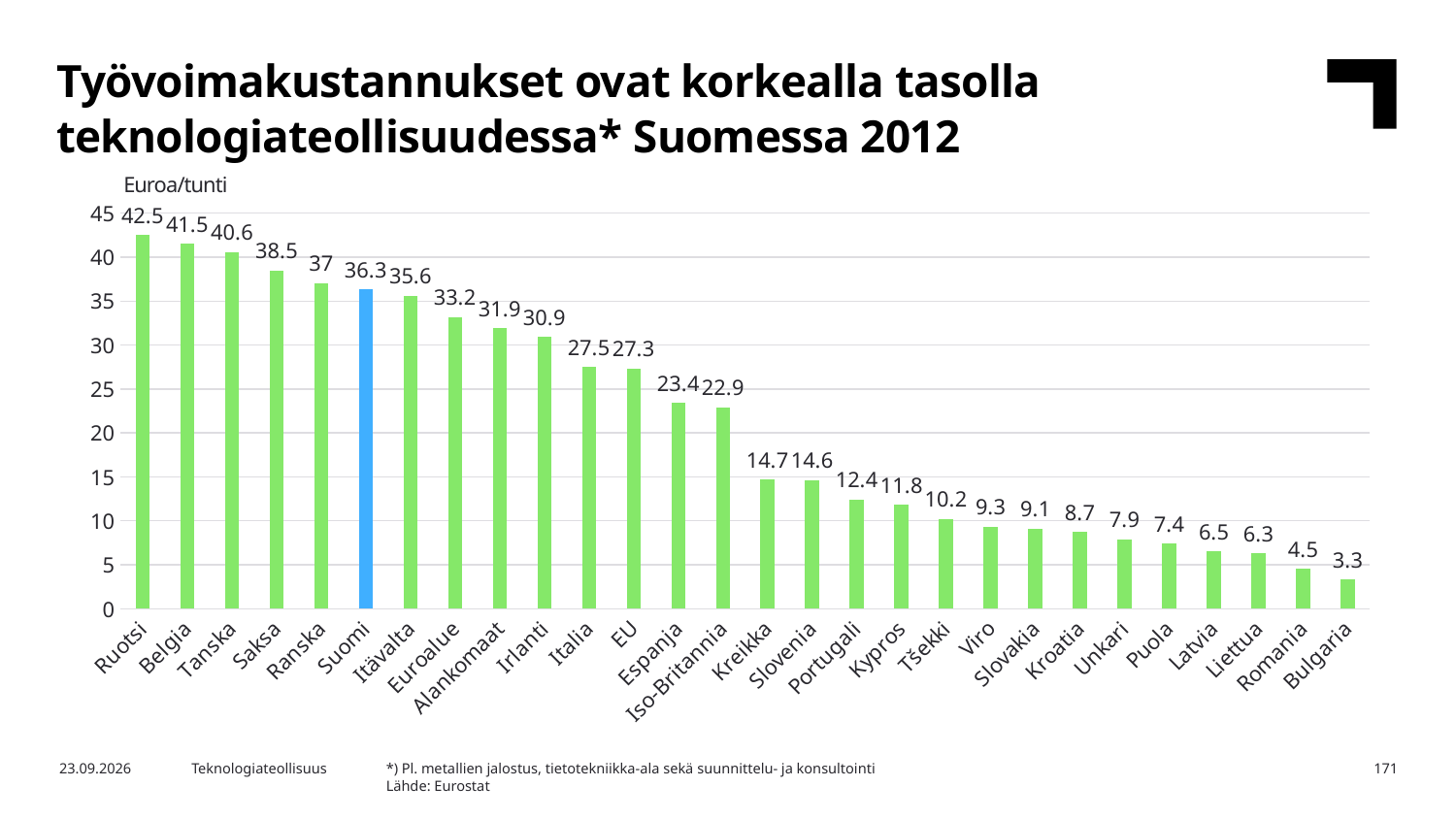
Which category's bar is coloured blue instead of green? Suomi Do the values rise or fall from left to right along the x axis? Fall Which has a higher value, Espanja or Kreikka? Espanja What is the difference between the values for Ruotsi and Suomi? 6.2 How many categories are shown on the x axis? 28 What is the value for Viro? 9.3 What kind of chart is shown on the slide? Bar chart Is the value for Irlanti greater or less than 30? greater Which country has the lowest labour cost per hour? Bulgaria Which country has the highest labour cost per hour? Ruotsi What is the difference between the values for Saksa and Ranska? 1.5 What is the value for Suomi? 36.3